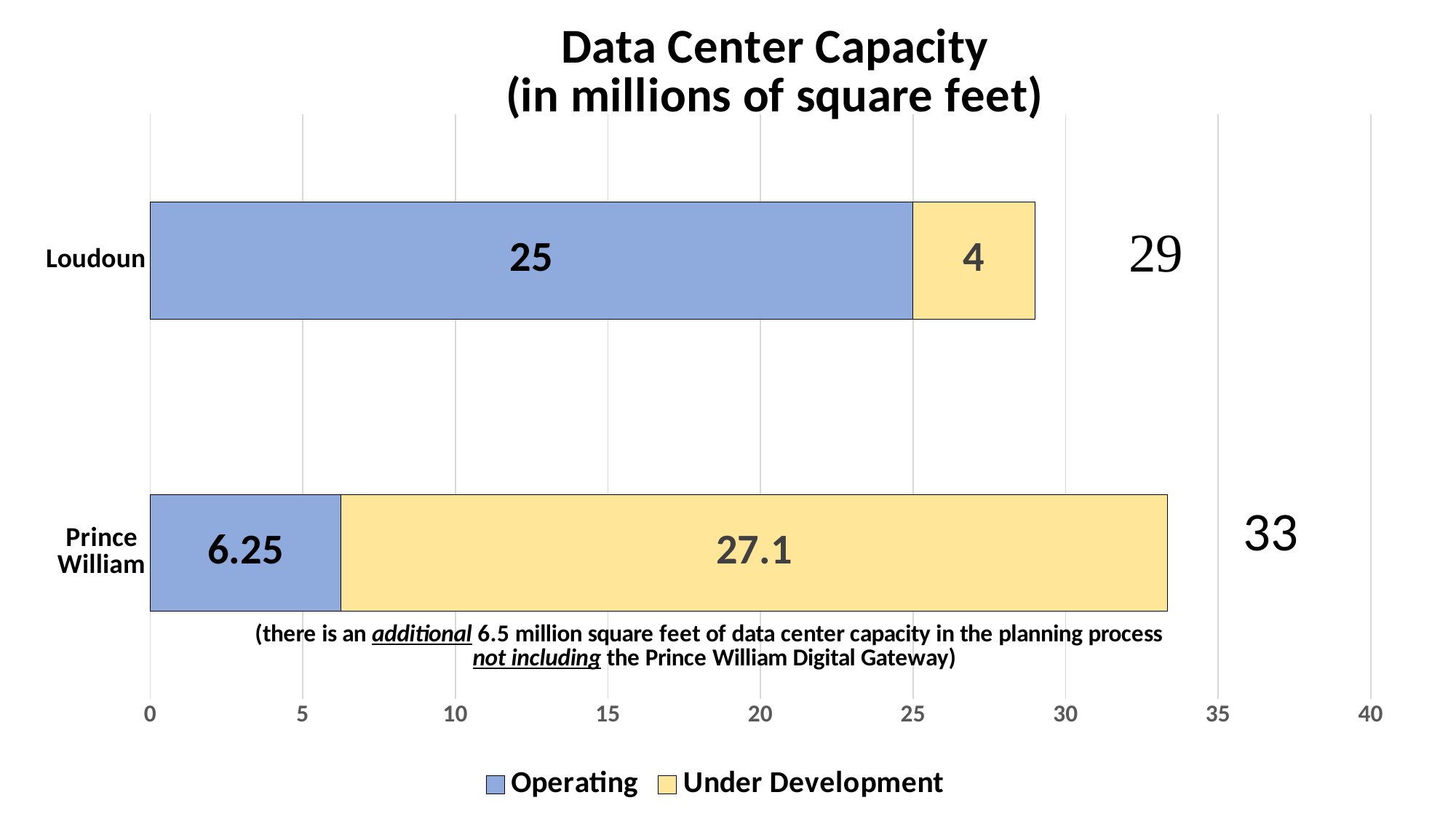
What type of chart is shown on the slide? Stacked bar chart What is the difference between Loudoun's Operating capacity and Prince William's Operating capacity? 18.75 What is the total capacity shown for the Loudoun bar? 29 What total value is printed next to the Prince William bar? 33 What is the title of the chart? Data Center Capacity (in millions of square feet) What is the Under Development capacity for Loudoun? 4 How many series does the legend list? 2 What is the Operating capacity for Prince William? 6.25 Which county has the larger Operating capacity, Loudoun or Prince William? Loudoun Which county has the highest Under Development capacity? Prince William What is the Under Development capacity for Prince William? 27.1 What is the Operating capacity for Loudoun? 25